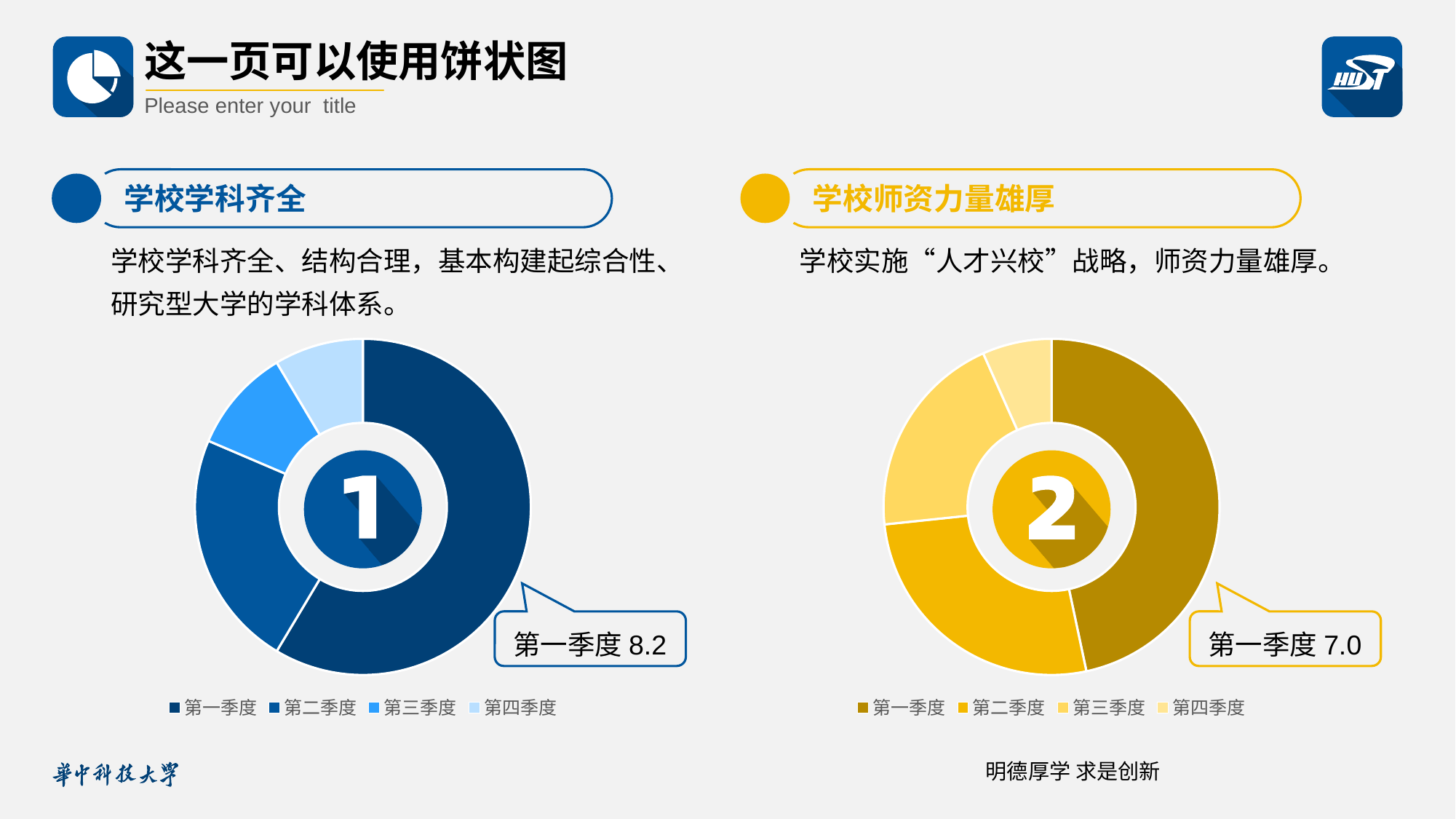
In the right chart, which category has the largest slice? 第一季度 In the left chart, which category has the smallest slice? 第四季度 In the right chart, what is the value shown for 第一季度? 7.0 In the right chart, which category has the smallest slice? 第四季度 What kind of chart is the left chart? Pie chart In the left chart, what is the value shown for 第一季度? 8.2 What number is printed in the centre of the right chart? 2 How many categories does the legend of the left chart list? 4 Which is larger: the 第一季度 value in the left chart or the 第一季度 value in the right chart? The left chart (8.2) What is the difference between the 第一季度 value in the left chart (8.2) and the 第一季度 value in the right chart (7.0)? 1.2 How many categories does the legend of the right chart list? 4 In the left chart, which category has the largest slice? 第一季度